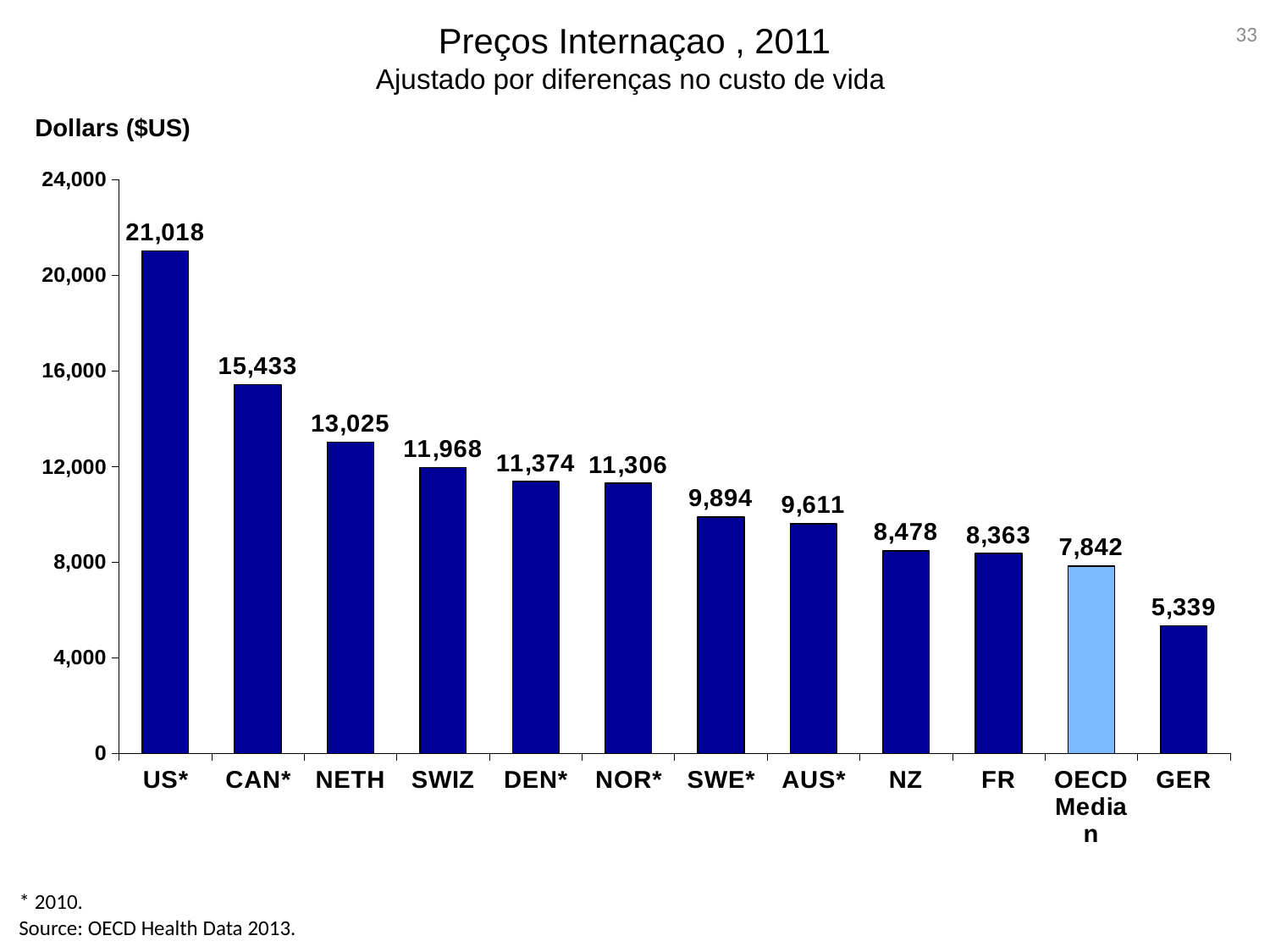
What is the difference between the values for US* and CAN*? 5,585 What unit is shown on the y-axis label? Dollars ($US) What kind of chart is shown on the slide? bar chart Which is larger, the value for SWE* or the value for NZ? SWE* What is the value for the OECD Median? 7,842 Which category has the lowest value? GER What is the value for NETH? 13,025 What is the difference between the values for FR and GER? 3,024 Which category has the highest value? US* What is the value for US*? 21,018 Is the value for SWIZ greater or less than 12,000? less How many bars are shown in the chart? 12